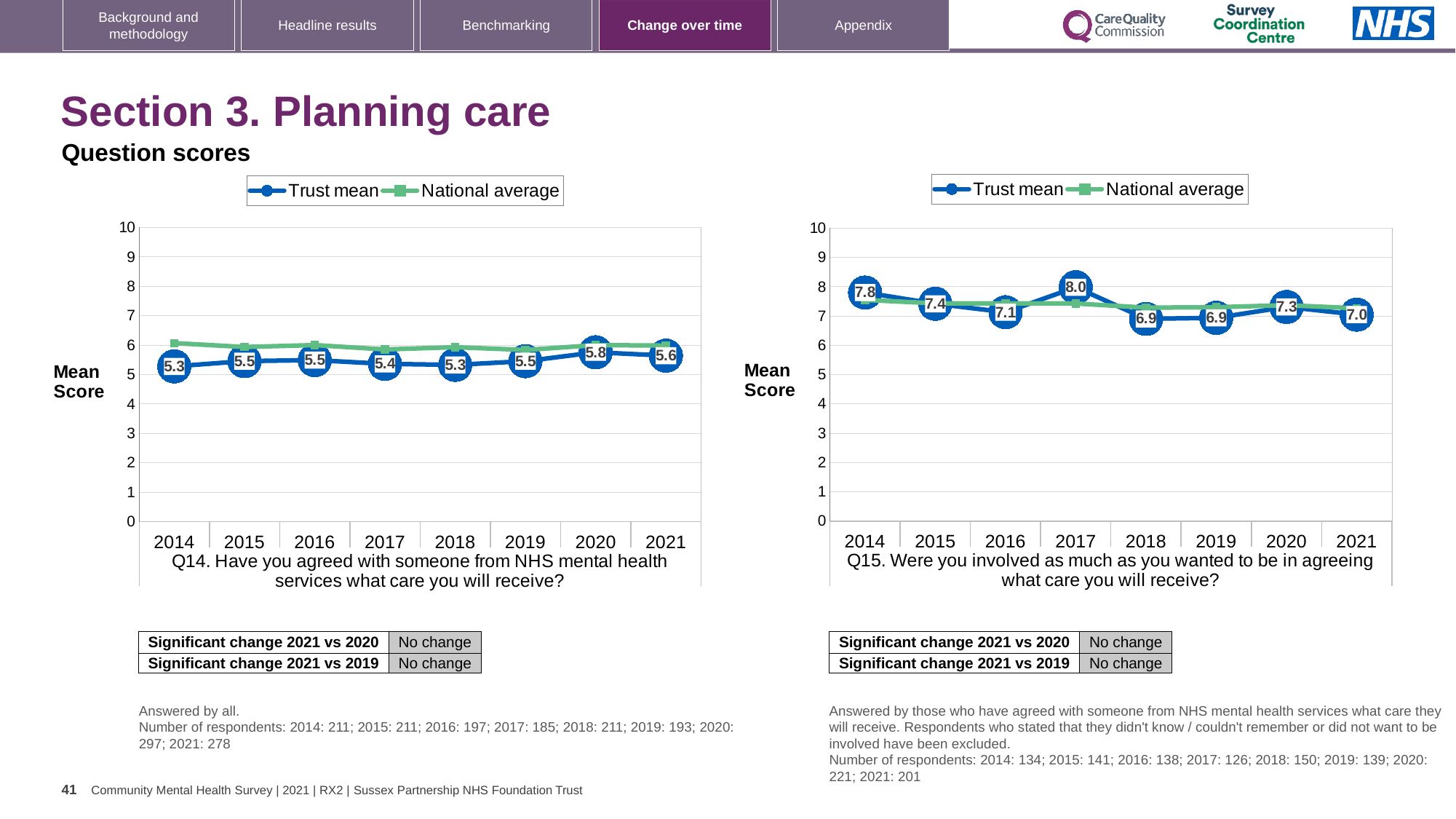
In the Q14 chart, which year has the highest Trust mean score? 2020 In the Q15 chart, what is the difference between the Trust mean scores for 2017 and 2018? 1.1 How many years are plotted on the x axis of the Q14 chart? 8 In the Q15 chart, what is the Trust mean score for 2017? 8.0 In the Q14 chart, what is the difference between the Trust mean scores for 2020 and 2014? 0.5 In the Q15 chart, is the National average value for 2014 greater or less than 7? greater In the Q14 chart, what is the Trust mean score for 2020? 5.8 What type of chart is used for Q14? Line chart In the Q15 chart, which year has the highest Trust mean score? 2017 In the Q14 chart, what is the Trust mean score for 2021? 5.6 In the Q15 chart, is the Trust mean score for 2014 larger than the Trust mean score for 2021? Yes, 2014 (7.8) is larger than 2021 (7.0) How many series does the legend of the Q15 chart list? 2